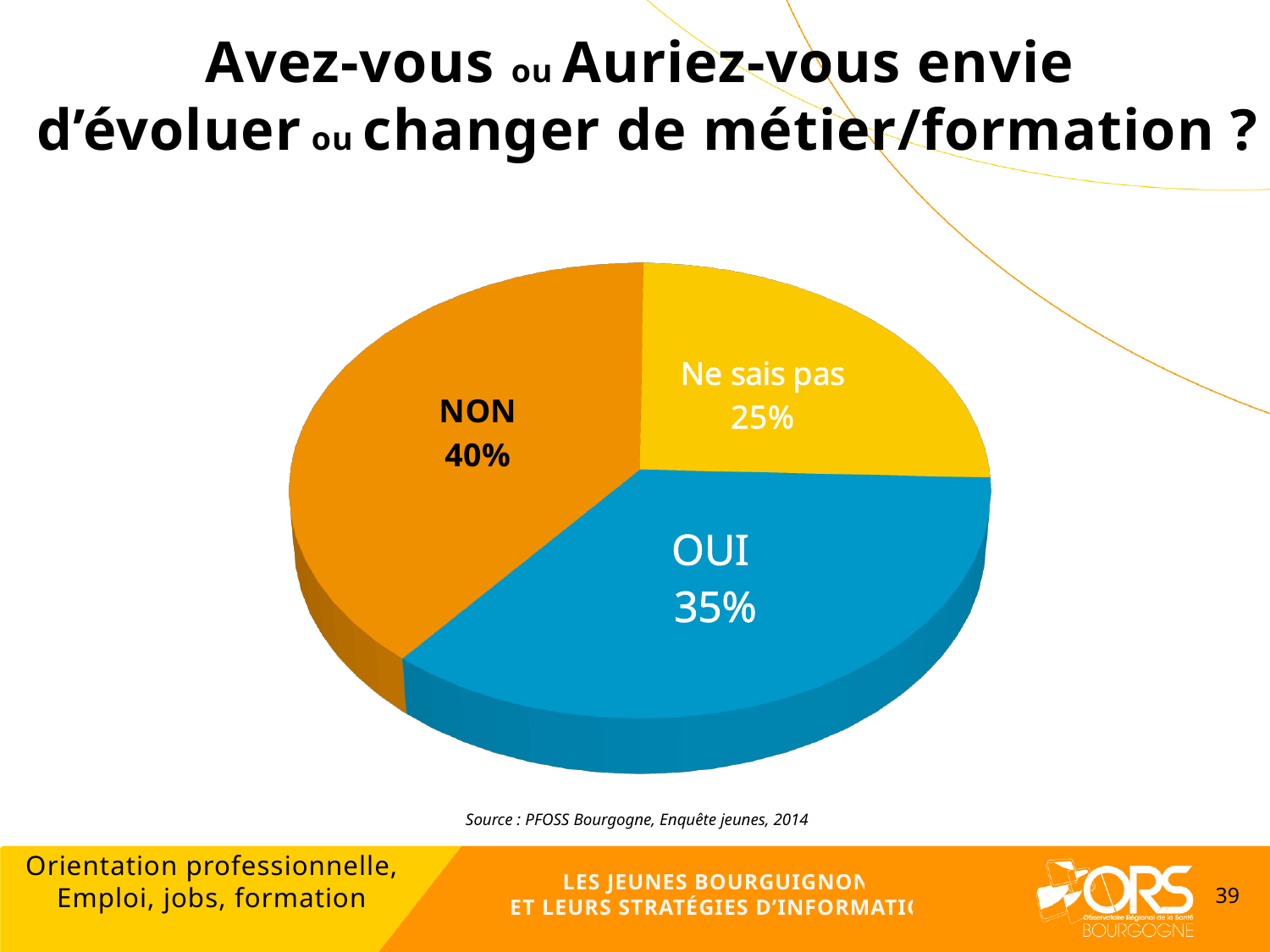
Which response has the largest share of the pie? NON Which response has the smallest share of the pie? Ne sais pas Which is larger, the share for OUI or the share for Ne sais pas? OUI What colour is the OUI slice? blue What percentage of respondents answered NON? 40% How many slices does the pie chart have? 3 What kind of chart is shown on the slide? pie chart What is the difference in percentage points between NON and OUI? 5 What is the difference in percentage points between OUI and Ne sais pas? 10 What percentage of respondents answered OUI? 35% What percentage of respondents answered Ne sais pas? 25% What source is cited below the chart? PFOSS Bourgogne, Enquête jeunes, 2014